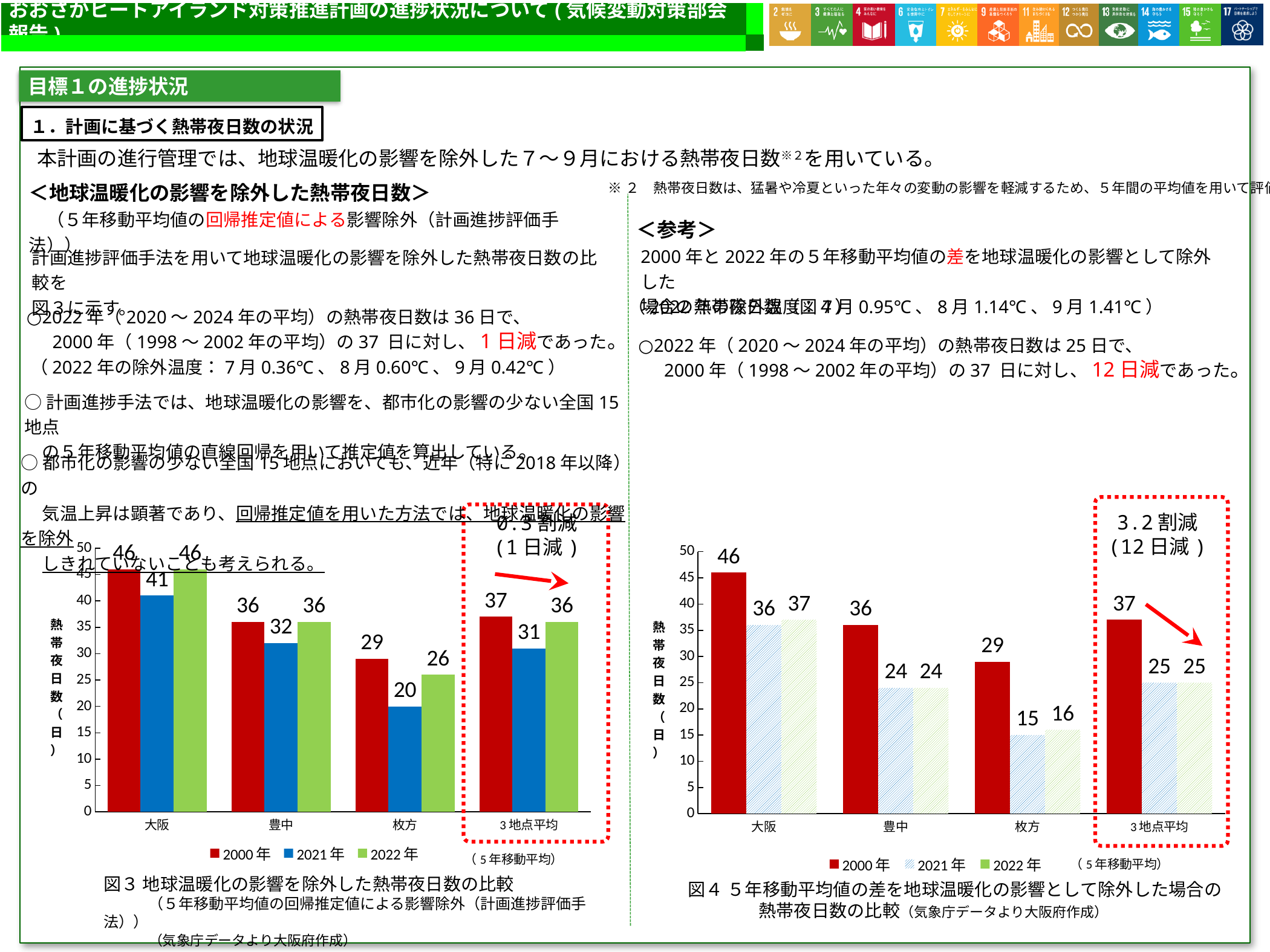
How many categories are shown on the x axis of the right chart (図4)? 4 In the left chart (図3), what is the value for 枚方 in the 2021年 series? 20 In the right chart (図4), which category has the highest value in the 2000年 series? 大阪 In the right chart (図4), what is the value for 豊中 in the 2021年 series? 24 In the left chart (図3), which category has the lowest value in the 2021年 series? 枚方 What kind of chart is the right chart (図4)? Bar chart In the right chart (図4), what is the value for 3地点平均 in the 2022年 series? 25 In the right chart (図4), what is the difference between the 2021年 and 2022年 values for 枚方? 1 In the right chart (図4), what is the difference between the 2000年 and 2022年 values for 3地点平均? 12 How many series does the legend of the left chart (図3) list? 3 In the left chart (図3), what is the value for 3地点平均 in the 2022年 series? 36 In the left chart (図3), which is larger for 大阪: the 2021年 value or the 2022年 value? 2022年